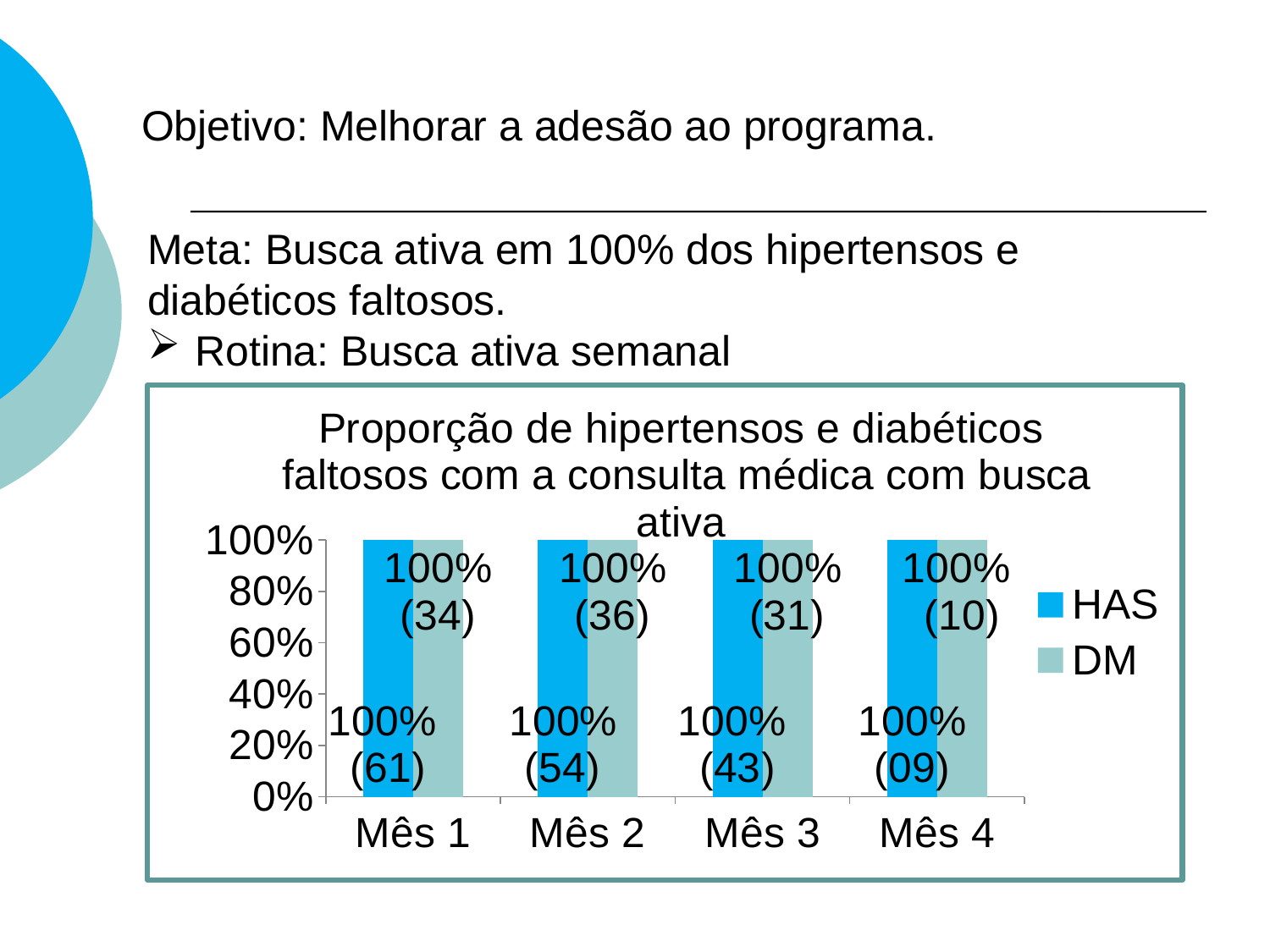
Do the HAS percentages rise, fall or stay the same from Mês 1 to Mês 4? Stay the same What is the value for DM in Mês 1? 100% (34) How many series does the legend list? 2 What are the two series named in the legend? HAS and DM What kind of chart is shown on the slide? Bar chart What is the value for HAS in Mês 4? 100% (09) How many categories (months) are shown on the x axis? 4 What is the difference between the HAS and DM percentages in Mês 2? 0% What is the value for DM in Mês 2? 100% (36) What is the value for HAS in Mês 3? 100% (43) What is the value for HAS in Mês 1? 100% (61) What is the value for DM in Mês 4? 100% (10)